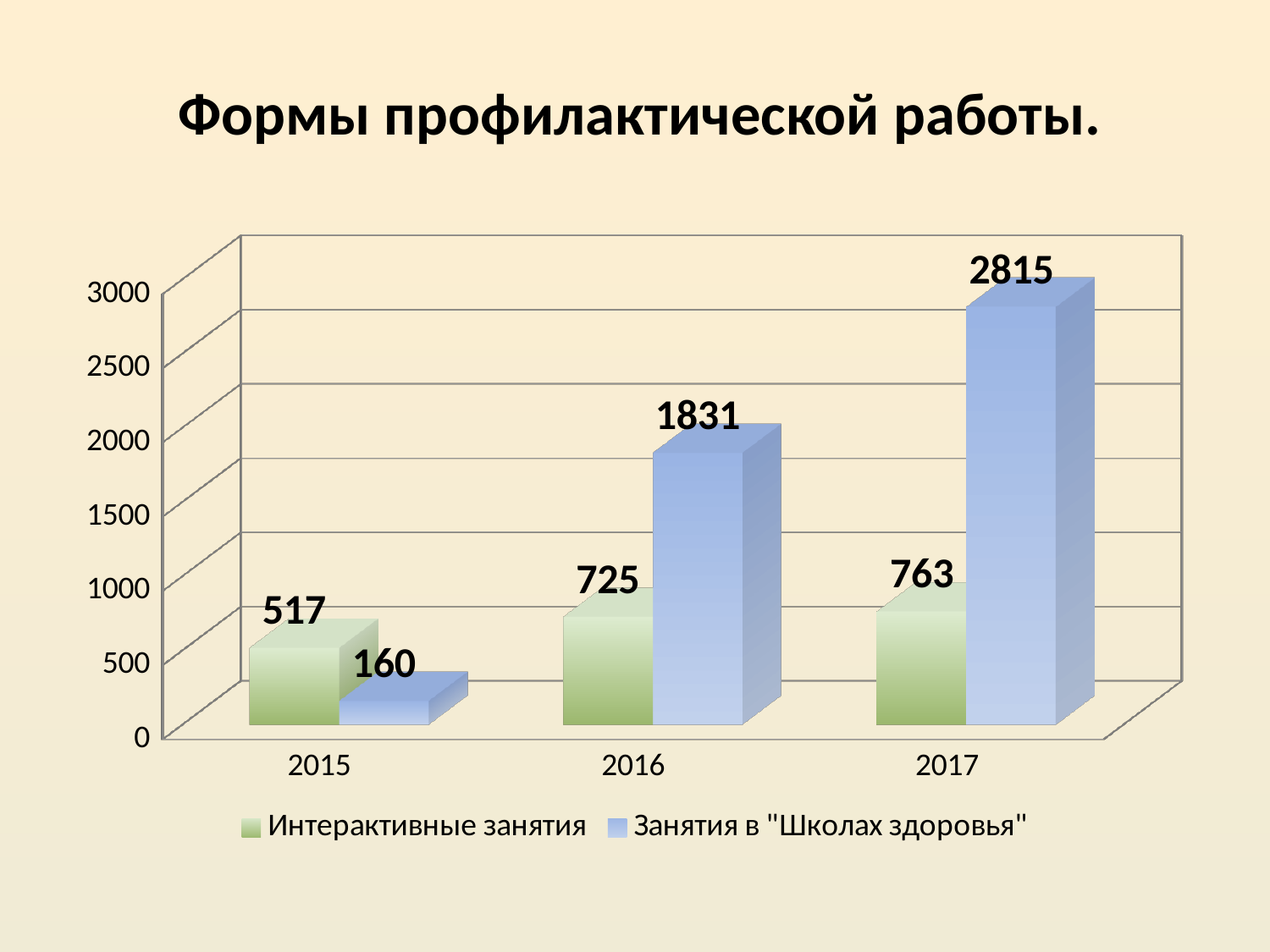
Do the values for Занятия в "Школах здоровья" rise or fall from 2015 to 2017? Rise What is the title of the chart? Формы профилактической работы. What kind of chart is shown on the slide? Bar chart In which year is the value for Интерактивные занятия highest? 2017 What is the value for Занятия в "Школах здоровья" in 2017? 2815 How many series does the legend list? 2 Which is larger in 2015: Интерактивные занятия or Занятия в "Школах здоровья"? Интерактивные занятия In which year is the value for Занятия в "Школах здоровья" lowest? 2015 What is the value for Интерактивные занятия in 2015? 517 What is the difference between Занятия в "Школах здоровья" and Интерактивные занятия in 2017? 2052 How many years are shown on the x axis? 3 What is the value for Занятия в "Школах здоровья" in 2016? 1831